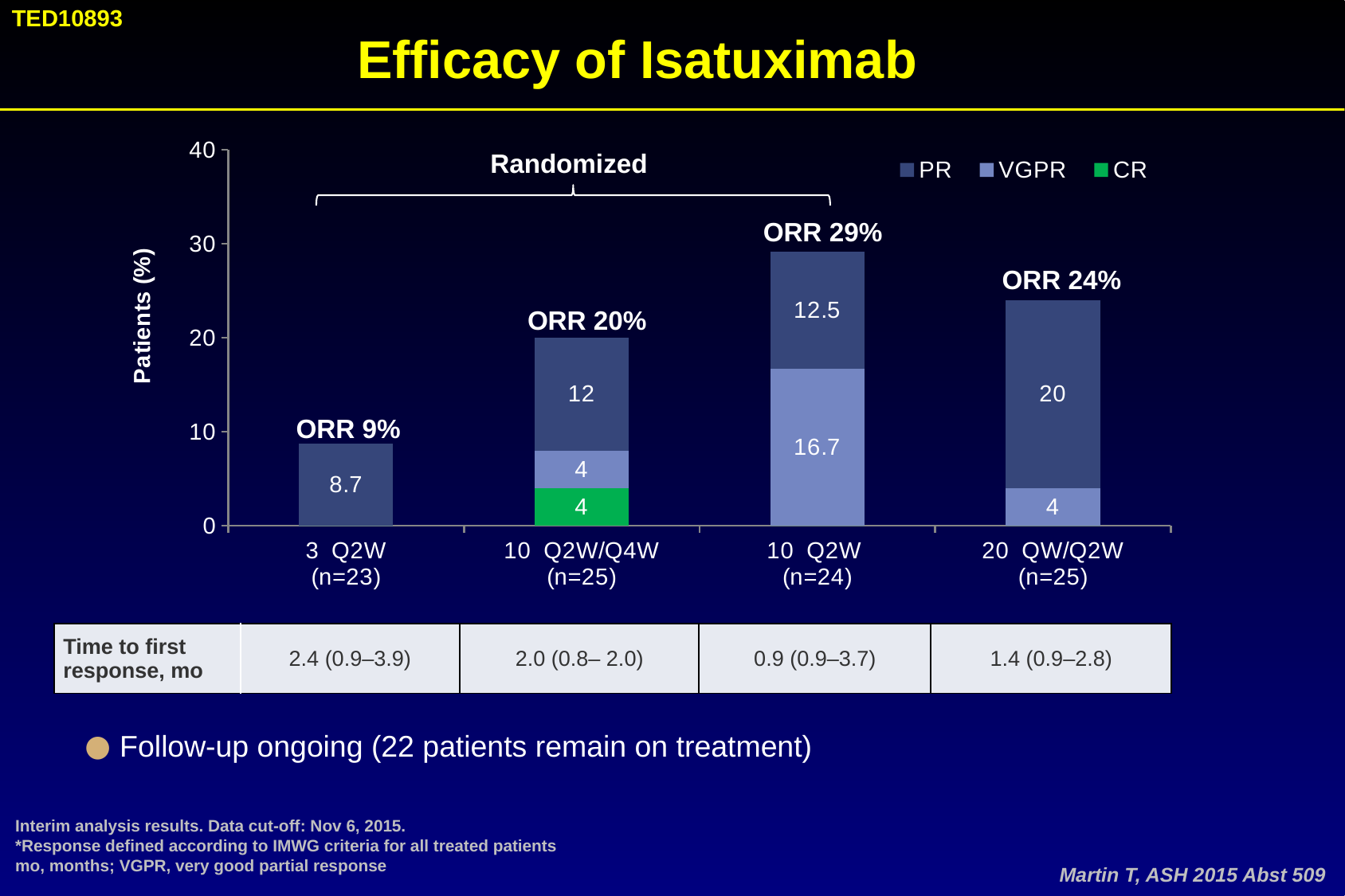
What is the PR value for the 20 QW/Q2W (n=25) group? 20 Which dose group has the highest ORR? 10 Q2W (n=24) What is the difference between the PR value for the 20 QW/Q2W group and the PR value for the 10 Q2W/Q4W group? 8 What is the PR value for the 3 Q2W (n=23) group? 8.7 How many dose groups are shown on the x axis of the chart? 4 Which is larger: the VGPR value for the 10 Q2W group or the PR value for the 10 Q2W group? VGPR (16.7) What kind of chart is shown on the slide? Stacked bar chart What is the ORR shown above the bar for the 20 QW/Q2W (n=25) group? ORR 24% What is the CR value for the 10 Q2W/Q4W (n=25) group? 4 Which dose group has the lowest ORR? 3 Q2W (n=23) What is the VGPR value for the 10 Q2W (n=24) group? 16.7 How many series does the chart legend list? 3